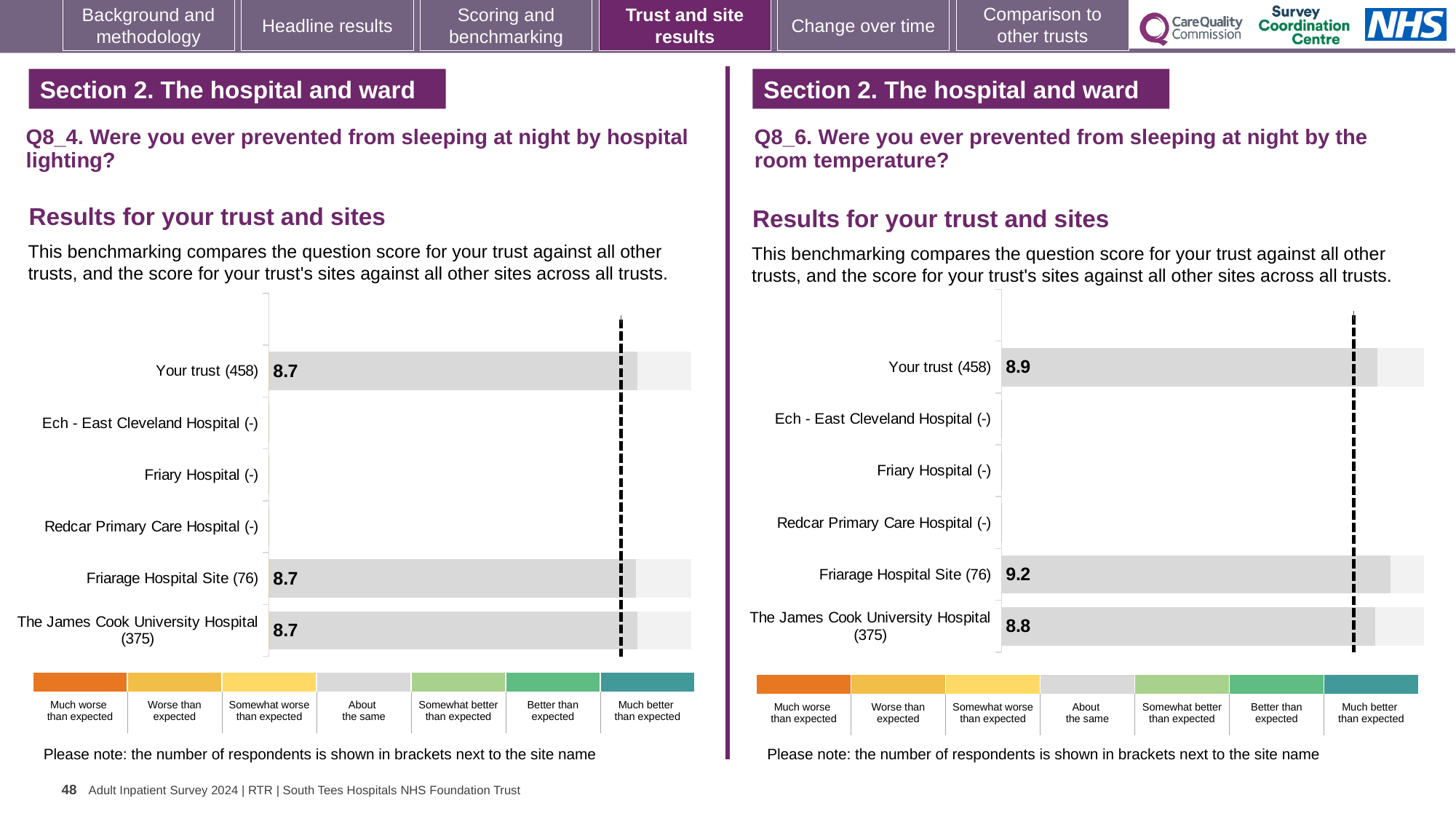
In the Q8_4 chart (hospital lighting), what is the score for Your trust (458)? 8.7 In the Q8_6 chart (room temperature), which has the larger score: Your trust (458) or Friarage Hospital Site (76)? Friarage Hospital Site (76) In the Q8_6 chart (room temperature), what is the score for The James Cook University Hospital (375)? 8.8 What kind of chart is used for the Q8_6 results (room temperature)? Bar chart In the Q8_4 chart (hospital lighting), what is the score for Friarage Hospital Site (76)? 8.7 In the Q8_6 chart (room temperature), which of the labelled bars has the lowest score? The James Cook University Hospital (375) How many benchmark categories are shown in the colour legend below the Q8_4 chart (hospital lighting)? 7 In the Q8_6 chart (room temperature), which site has the highest score? Friarage Hospital Site (76) In the Q8_6 chart (room temperature), what is the score for Your trust (458)? 8.9 How many categories are listed on the y axis of the Q8_4 chart (hospital lighting)? 6 In the Q8_6 chart (room temperature), what is the score for Friarage Hospital Site (76)? 9.2 In the Q8_6 chart (room temperature), what is the difference between the scores for Friarage Hospital Site (76) and The James Cook University Hospital (375)? 0.4